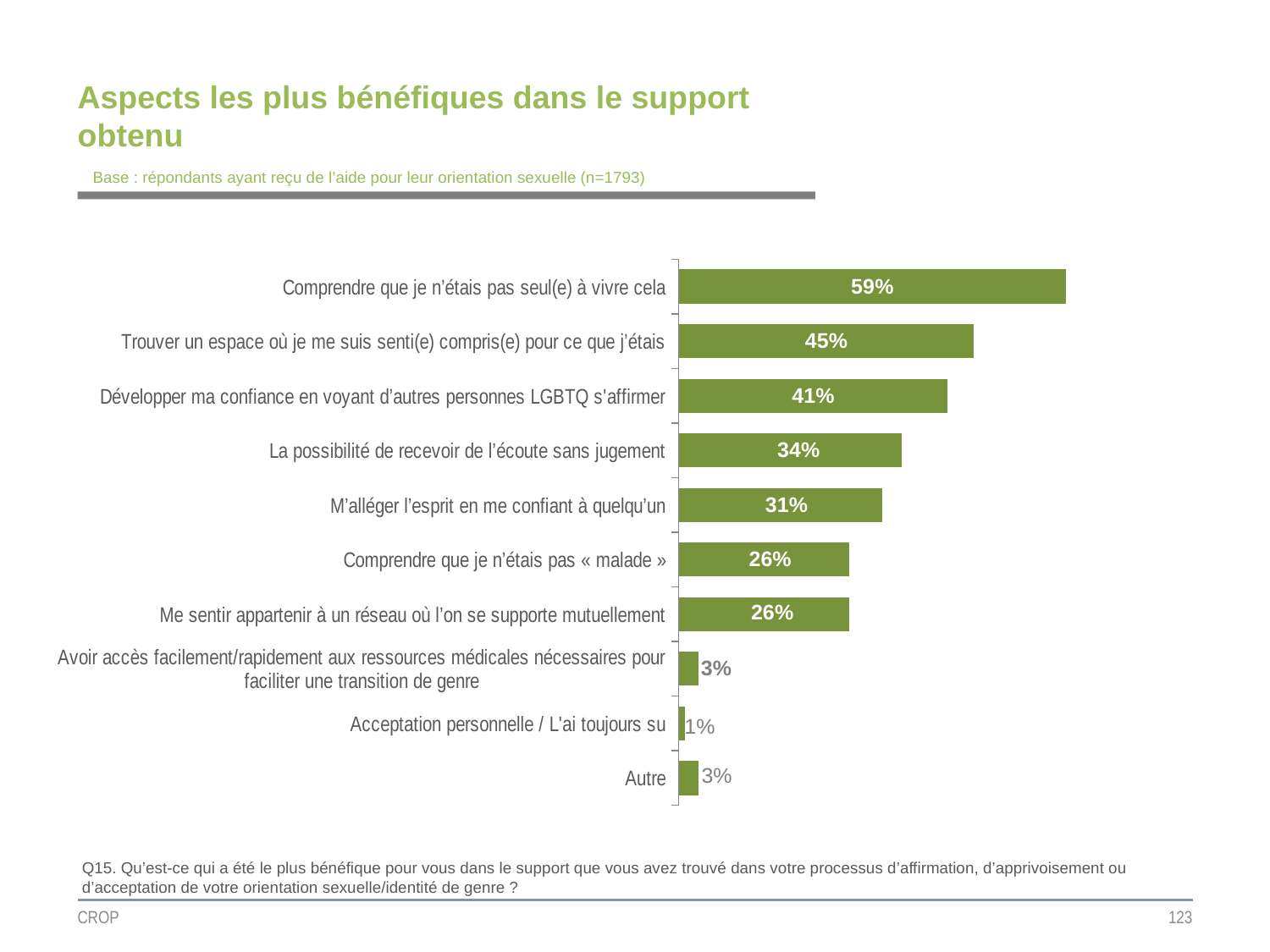
Which category has the highest value? Comprendre que je n’étais pas seul(e) à vivre cela What is the value for "Comprendre que je n’étais pas seul(e) à vivre cela"? 59% What is the difference between "Comprendre que je n’étais pas seul(e) à vivre cela" and "Trouver un espace où je me suis senti(e) compris(e) pour ce que j’étais"? 14% What is the base size (n) stated for the chart? n=1793 What is the title of the chart on the slide? Aspects les plus bénéfiques dans le support obtenu Which category has the lowest value? Acceptation personnelle / L'ai toujours su What is the value for "La possibilité de recevoir de l’écoute sans jugement"? 34% How many categories are shown in the chart? 10 What is the value for "Acceptation personnelle / L'ai toujours su"? 1% What is the value for "Autre"? 3% Which is larger: "Développer ma confiance en voyant d’autres personnes LGBTQ s'affirmer" or "M’alléger l’esprit en me confiant à quelqu’un"? Développer ma confiance en voyant d’autres personnes LGBTQ s'affirmer What kind of chart is shown on the slide? Bar chart